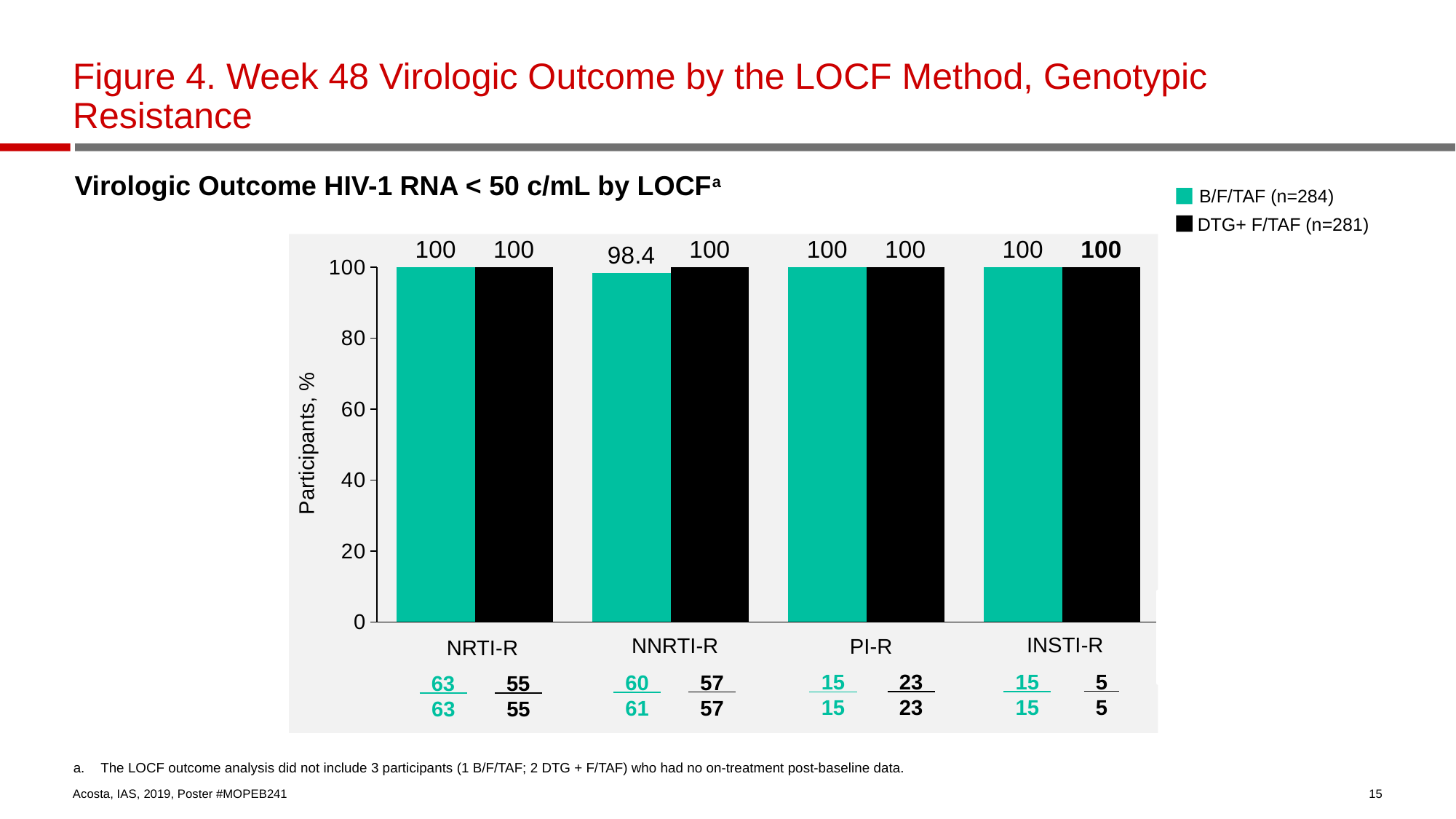
What is the label of the y axis? Participants, % What is the value for DTG+ F/TAF in the NRTI-R category? 100 What is the value for B/F/TAF in the NNRTI-R category? 98.4 Is the value for B/F/TAF in the PI-R category greater or less than 80? greater What kind of chart is shown on the slide? bar chart Which series is shown in black? DTG+ F/TAF (n=281) How many categories are shown on the x axis? 4 What is the value for B/F/TAF in the INSTI-R category? 100 How many series does the legend list? 2 In the NNRTI-R category, which series has the larger value, B/F/TAF or DTG+ F/TAF? DTG+ F/TAF Which category has the lowest value for B/F/TAF? NNRTI-R What is the difference between the DTG+ F/TAF and B/F/TAF values in the NNRTI-R category? 1.6